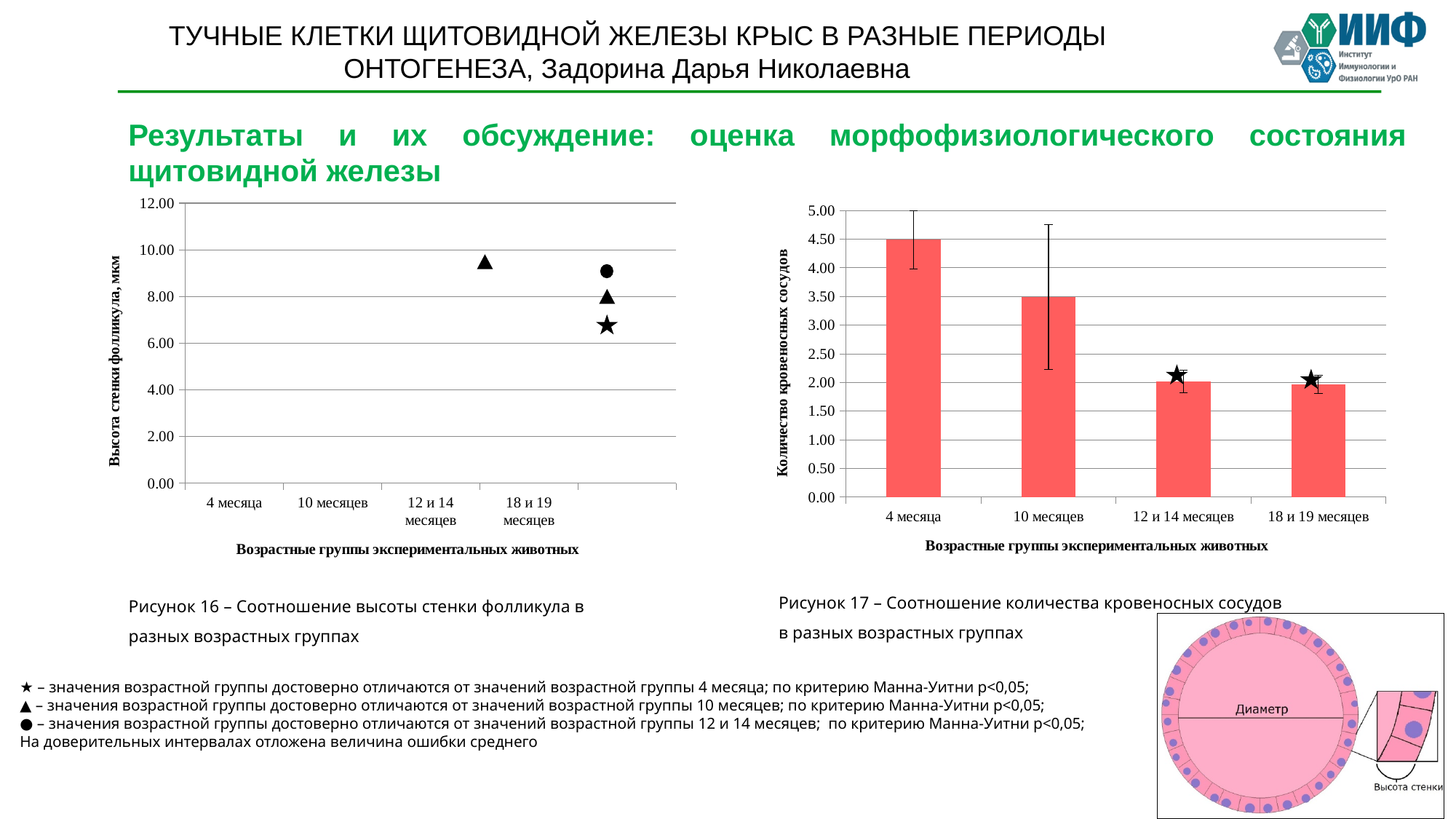
In the right chart (Рисунок 17), is the value for 10 месяцев greater or less than 3.00? greater In the right chart (Рисунок 17), which age group has the highest number of blood vessels? 4 месяца In the right chart (Рисунок 17), is the value for 18 и 19 месяцев greater or less than 1.50? greater In the right chart (Рисунок 17), is the value for 4 месяца greater or less than 4.00? greater What is the y-axis title of the right chart (Рисунок 17)? Количество кровеносных сосудов In the left chart (Рисунок 16), how many age groups are labelled on the x axis? 4 What is the x-axis title of the left chart (Рисунок 16)? Возрастные группы экспериментальных животных In the right chart (Рисунок 17), how many age groups are shown on the x axis? 4 In the right chart (Рисунок 17), which is larger: the value for 4 месяца or for 10 месяцев? 4 месяца In the right chart (Рисунок 17), do the values rise or fall from 4 месяца to 18 и 19 месяцев? fall What kind of chart is the right chart (Рисунок 17)? bar chart